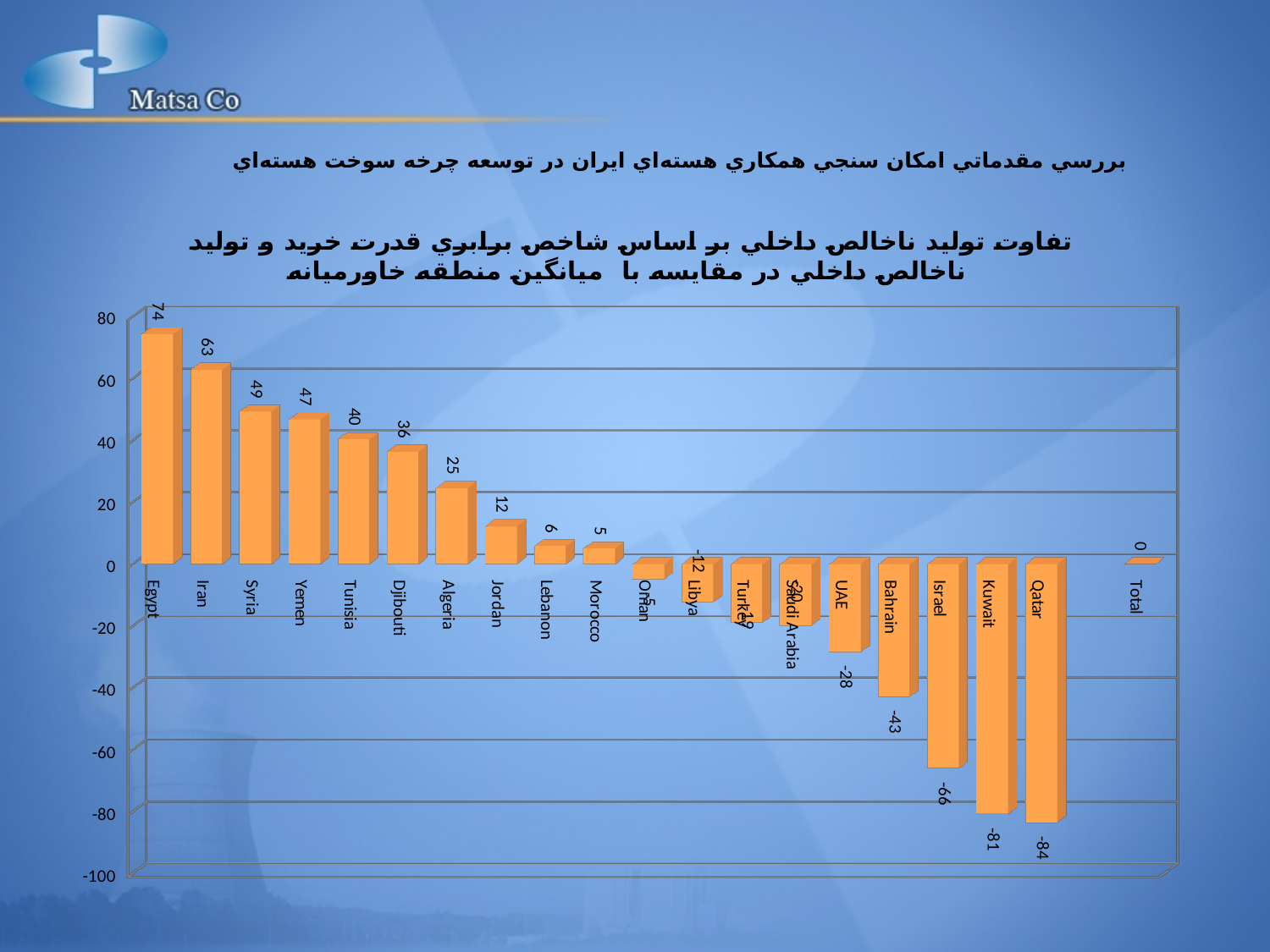
Do the values rise or fall from left to right along the x axis? fall What is the difference between the values for Egypt and Iran? 11 Which country has the lowest value? Qatar What is the value for Qatar? -84 How many categories are shown on the x axis? 20 What kind of chart is this? bar chart Which has a larger value, Syria or Yemen? Syria What is the value for Egypt? 74 Is the value for Bahrain greater or less than -40? less Which country has the highest value? Egypt What is the value for Israel? -66 What is the value for Iran? 63